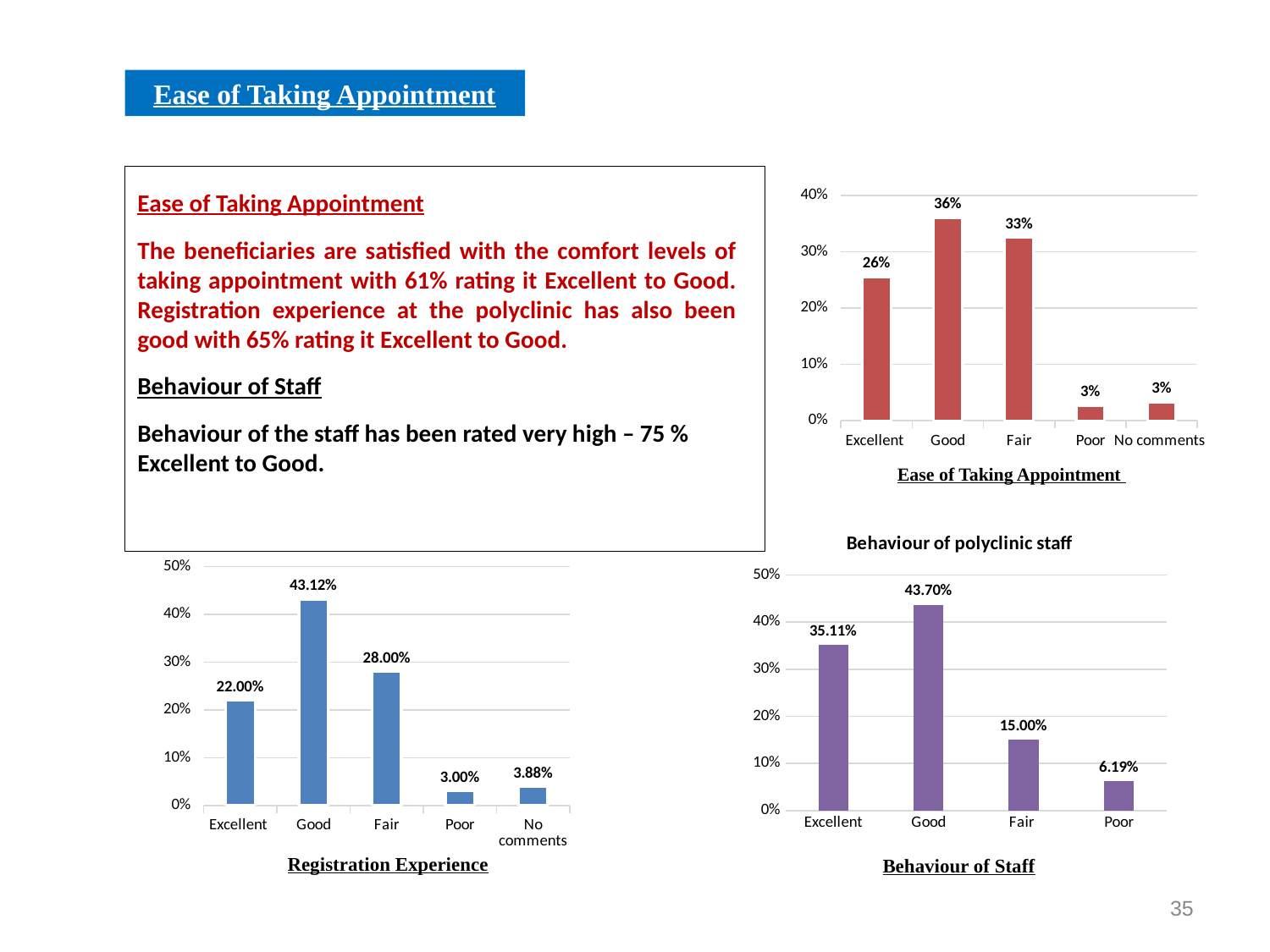
In the Registration Experience chart, which category has the lowest value? Poor In the Behaviour of Staff chart, how many categories are shown on the x axis? 4 In the Registration Experience chart, what is the difference between Good and Fair? 15.12% In the Behaviour of Staff chart, which is larger, Excellent or Fair? Excellent In the Ease of Taking Appointment chart, which category has the highest value? Good In the Behaviour of Staff chart, what is the value for Poor? 6.19% In the Registration Experience chart, is the value for Good greater or less than 40%? greater In the Registration Experience chart, what is the value for Fair? 28.00% In the Ease of Taking Appointment chart, what is the value for Good? 36% In the Ease of Taking Appointment chart, how many categories are shown on the x axis? 5 In the Ease of Taking Appointment chart, what is the difference between Good and Excellent? 10% What type of chart is the Behaviour of Staff chart? Bar chart